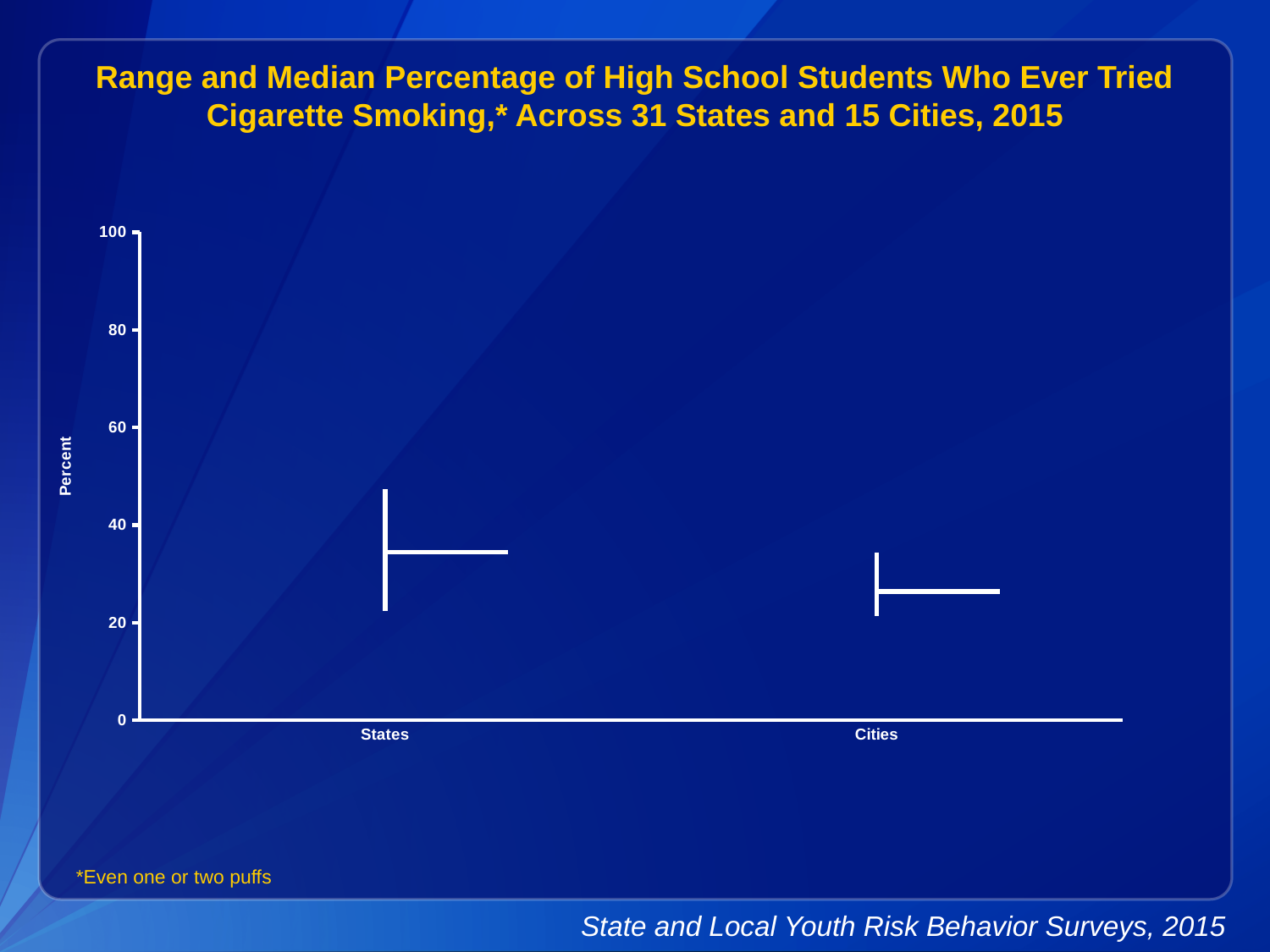
Which category shows the wider range of percentages? States Is the top of the range for Cities greater or less than 40? less What is the label of the y axis? Percent What is the highest value shown on the y axis? 100 Is the median value for Cities greater or less than 40? less Is the median value for States greater or less than 20? greater How many categories are shown on the x axis of the chart? 2 Which category has the higher median percentage, States or Cities? States